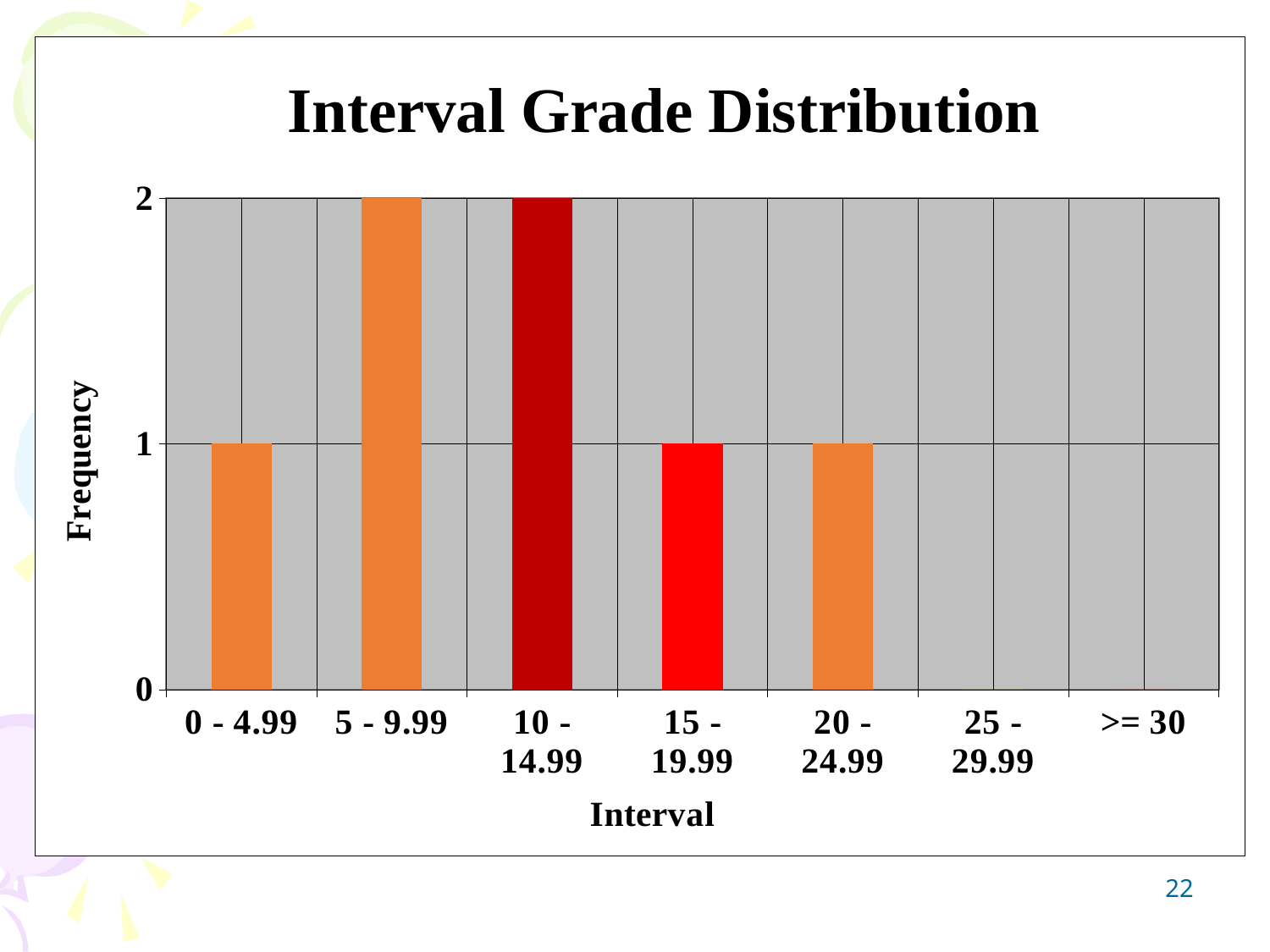
Which intervals have the highest frequency? 5 - 9.99 and 10 - 14.99 What is the title of the chart? Interval Grade Distribution What is the difference in frequency between the 10 - 14.99 interval and the 15 - 19.99 interval? 1 How many intervals have a frequency of 0? 2 What is the frequency for the interval 0 - 4.99? 1 Which has a higher frequency, the 5 - 9.99 interval or the 20 - 24.99 interval? 5 - 9.99 What is the frequency for the interval 25 - 29.99? 0 What is the frequency for the interval >= 30? 0 How many intervals are shown on the x axis? 7 What kind of chart is shown on the slide? Bar chart What is the frequency for the interval 5 - 9.99? 2 What is the frequency for the interval 10 - 14.99? 2